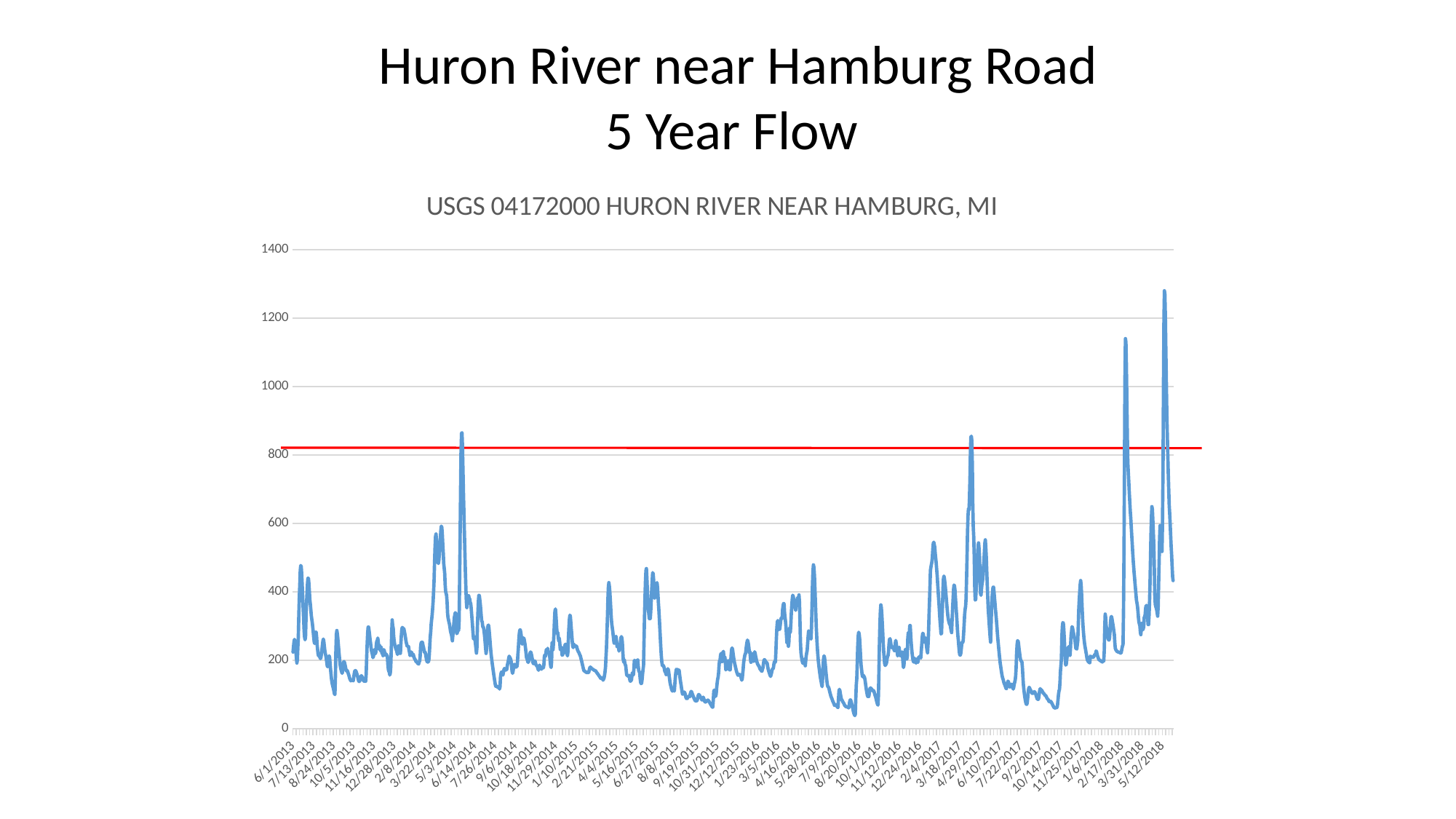
Is the peak of the flow line near 4/29/2017 greater or less than 600? greater What is the title printed above the chart's plot area? USGS 04172000 HURON RIVER NEAR HAMBURG, MI Near which x-axis date label does the highest peak of the flow line occur? 5/12/2018 Is the peak of the flow line near 6/14/2014 greater or less than 800? greater What colour is the horizontal reference line drawn across the chart? red Which peak is higher: the one near 5/12/2018 or the one near 2/17/2018? 5/12/2018 Is the peak of the flow line near 2/17/2018 greater or less than 1000? greater What kind of chart is shown on the slide? line chart How many peaks of the flow line rise above the red horizontal reference line? 4